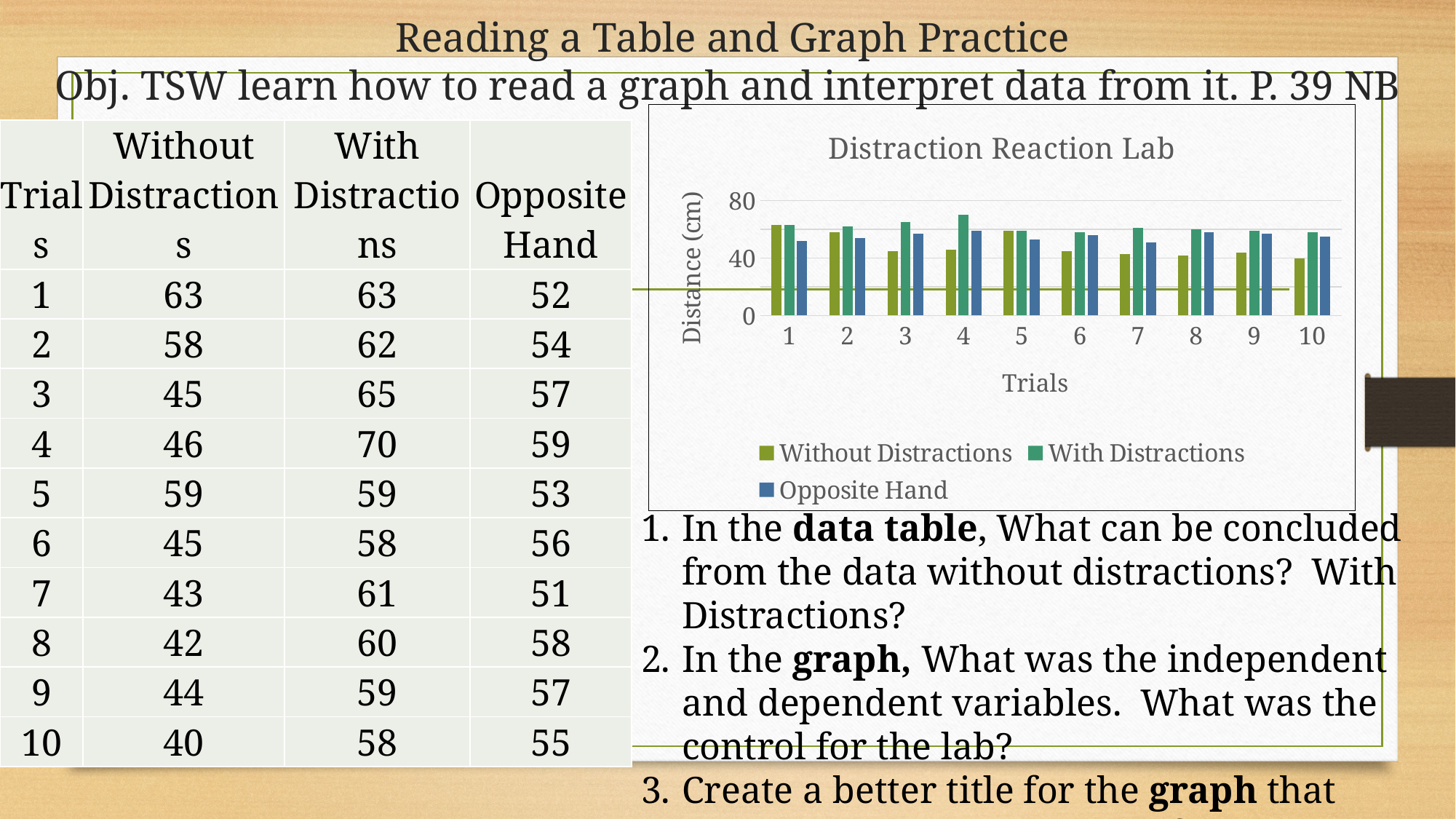
In the Distraction Reaction Lab chart, which trial has the highest With Distractions value? 4 In the Distraction Reaction Lab chart, is the Opposite Hand value for trial 1 greater or less than 40? greater In the Distraction Reaction Lab chart, is the With Distractions value for trial 4 greater or less than 40? greater What type of chart is the Distraction Reaction Lab chart? bar chart What is the title of the chart on the slide? Distraction Reaction Lab How many series does the legend of the Distraction Reaction Lab chart list? 3 According to the slide, what is the With Distractions distance for trial 4? 70 According to the slide, what is the difference between the With Distractions and Without Distractions values for trial 4? 24 What is the label of the y axis on the Distraction Reaction Lab chart? Distance (cm) In the Distraction Reaction Lab chart, which is larger for trial 4: Without Distractions or With Distractions? With Distractions In the Distraction Reaction Lab chart, do the Without Distractions values generally rise or fall from trial 1 to trial 10? fall How many trials are shown on the x axis of the Distraction Reaction Lab chart? 10